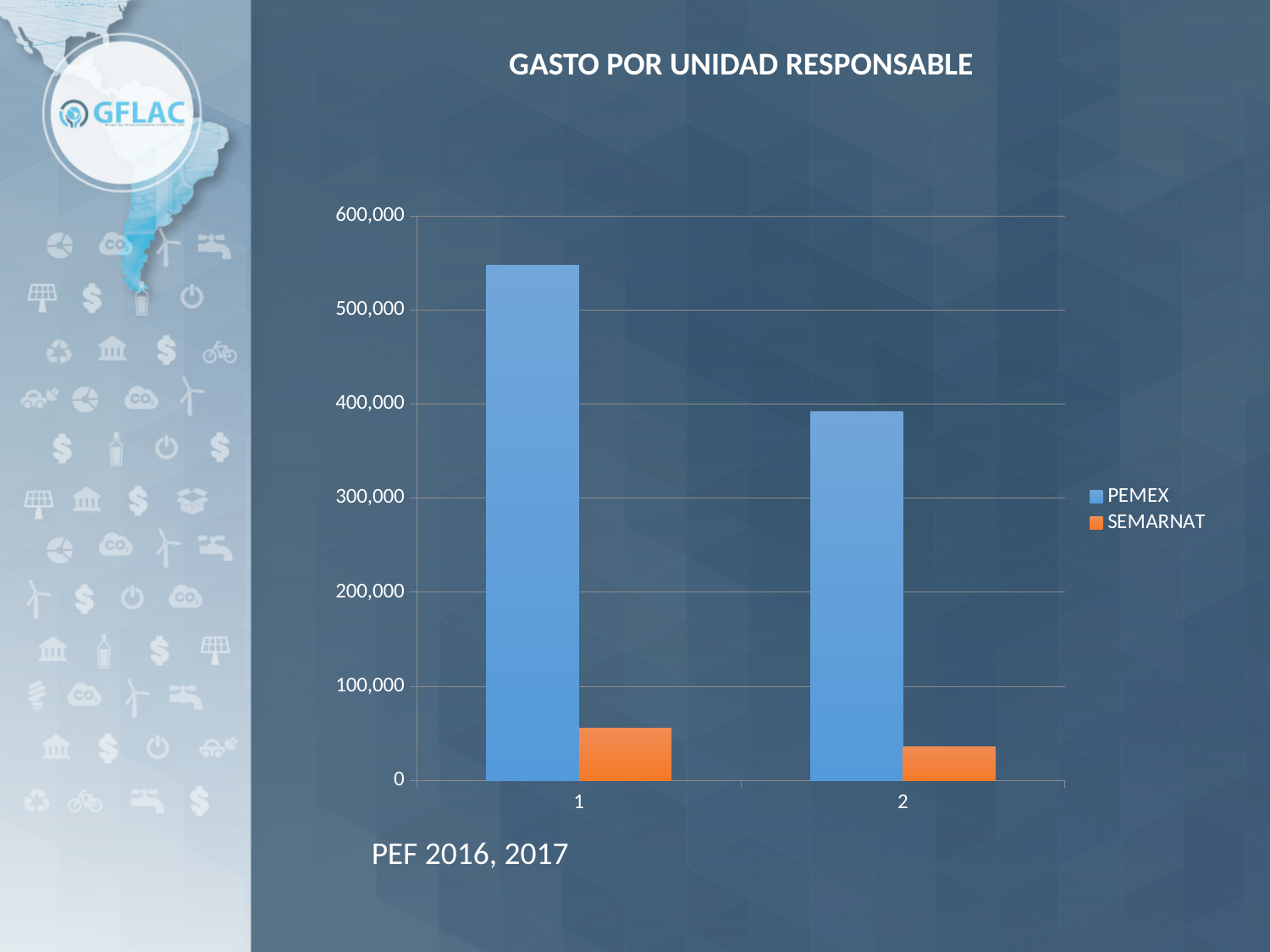
What is the title of the chart? GASTO POR UNIDAD RESPONSABLE Which bar is the lowest on the chart? SEMARNAT, category 2 How many series does the legend list? 2 Do the PEMEX values rise or fall from category 1 to category 2? fall Which series is shown in orange? SEMARNAT How many categories are shown on the x axis? 2 Is the PEMEX value for category 1 greater or less than 500,000? greater Is the SEMARNAT value for category 1 greater or less than 100,000? less Which series has the larger value for category 2, PEMEX or SEMARNAT? PEMEX Is the PEMEX value for category 2 greater or less than 300,000? greater For PEMEX, which category has the higher value, 1 or 2? 1 What kind of chart is shown on the slide? bar chart